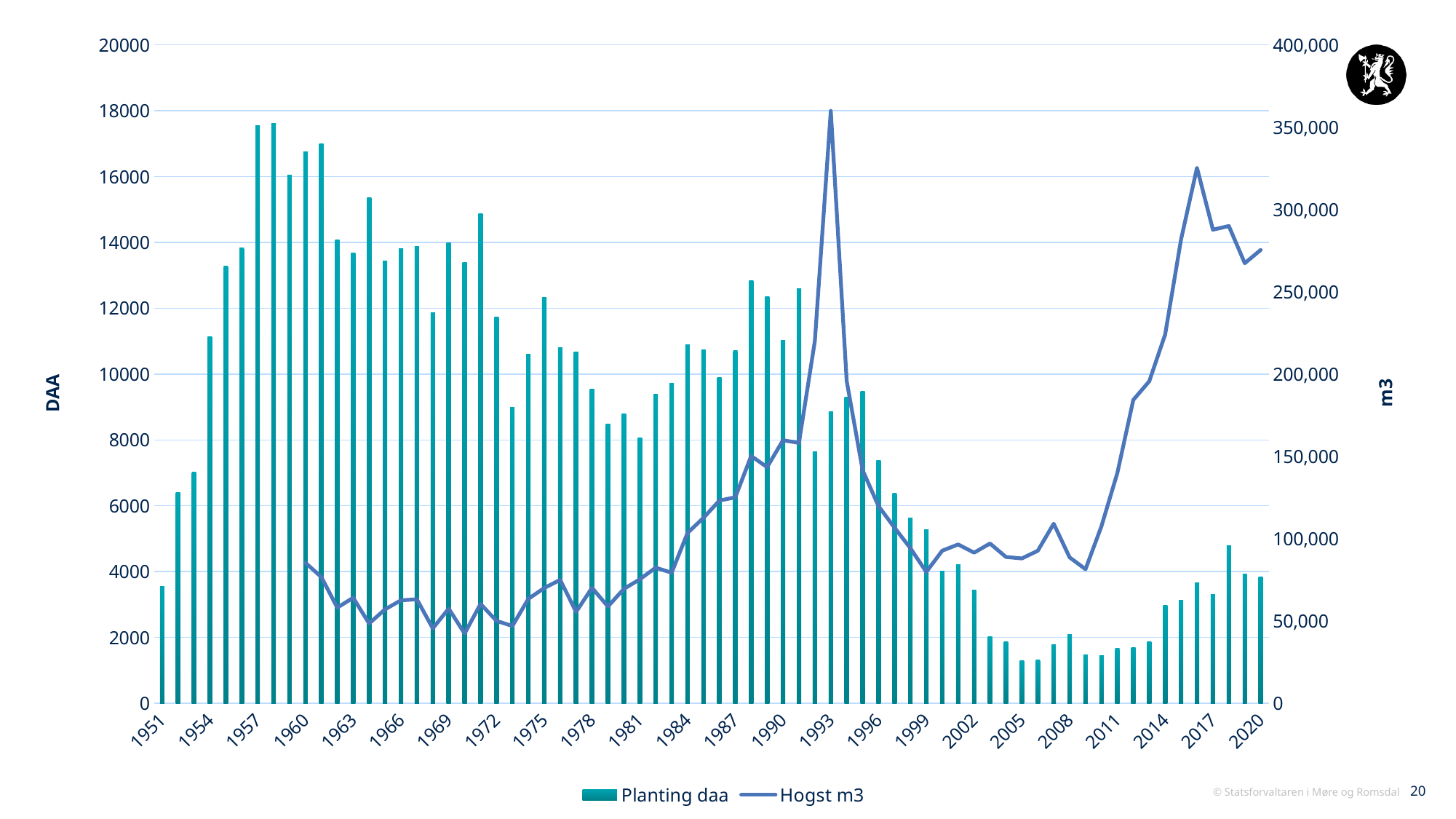
In which year does the Hogst m3 line reach its highest value? 1993 What are the two series named in the legend? Planting daa and Hogst m3 What kind of chart is shown on the slide? A combined bar and line chart Is the Hogst m3 value for 1993 greater or less than 300,000? greater Which year has the larger Planting daa value, 1958 or 2005? 1958 What is the title of the left vertical axis? DAA Is the Planting daa value for 1951 greater or less than 4000? less How many series does the legend list? 2 Does the Hogst m3 line rise or fall between 2011 and 2016? rise Is the Planting daa value for 2005 greater or less than 2000? less